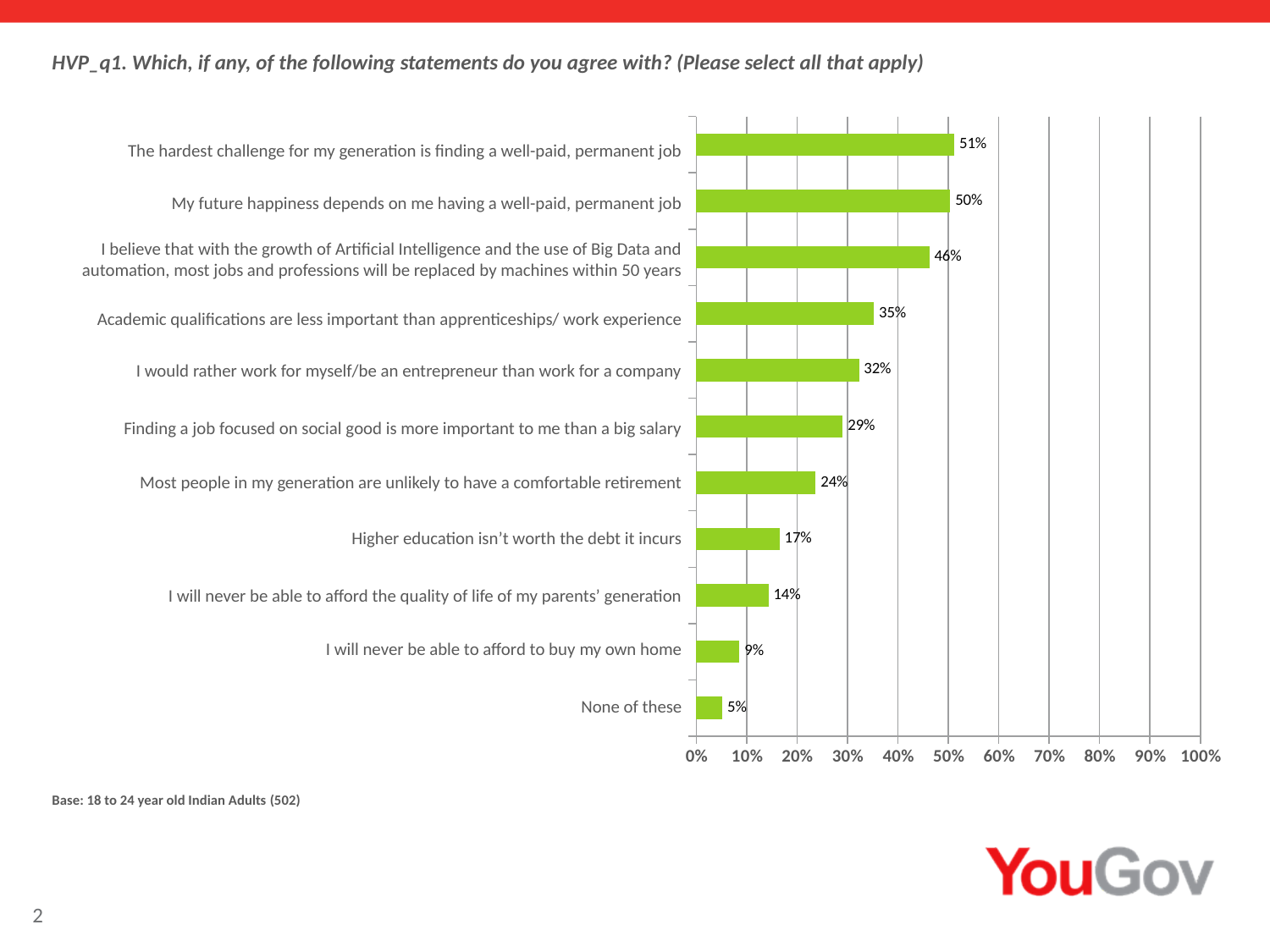
Is the value for "Finding a job focused on social good is more important to me than a big salary" greater or less than 40%? less What percentage selected "None of these"? 5% Which statement (excluding "None of these") has the lowest level of agreement? I will never be able to afford to buy my own home What is the value for the statement about Artificial Intelligence and Big Data replacing most jobs within 50 years? 46% What kind of chart is shown on the slide? Bar chart How many statements (bars) are shown in the chart? 11 What is the value for "I would rather work for myself/be an entrepreneur than work for a company"? 32% What is the difference between the values for "Academic qualifications are less important than apprenticeships/ work experience" and "Higher education isn't worth the debt it incurs"? 18% Which is larger: the value for "Most people in my generation are unlikely to have a comfortable retirement" or for "I will never be able to afford the quality of life of my parents' generation"? Most people in my generation are unlikely to have a comfortable retirement What is the base (sample) described below the chart? 18 to 24 year old Indian Adults (502) What percentage agreed that the hardest challenge for their generation is finding a well-paid, permanent job? 51% Which statement has the highest level of agreement? The hardest challenge for my generation is finding a well-paid, permanent job